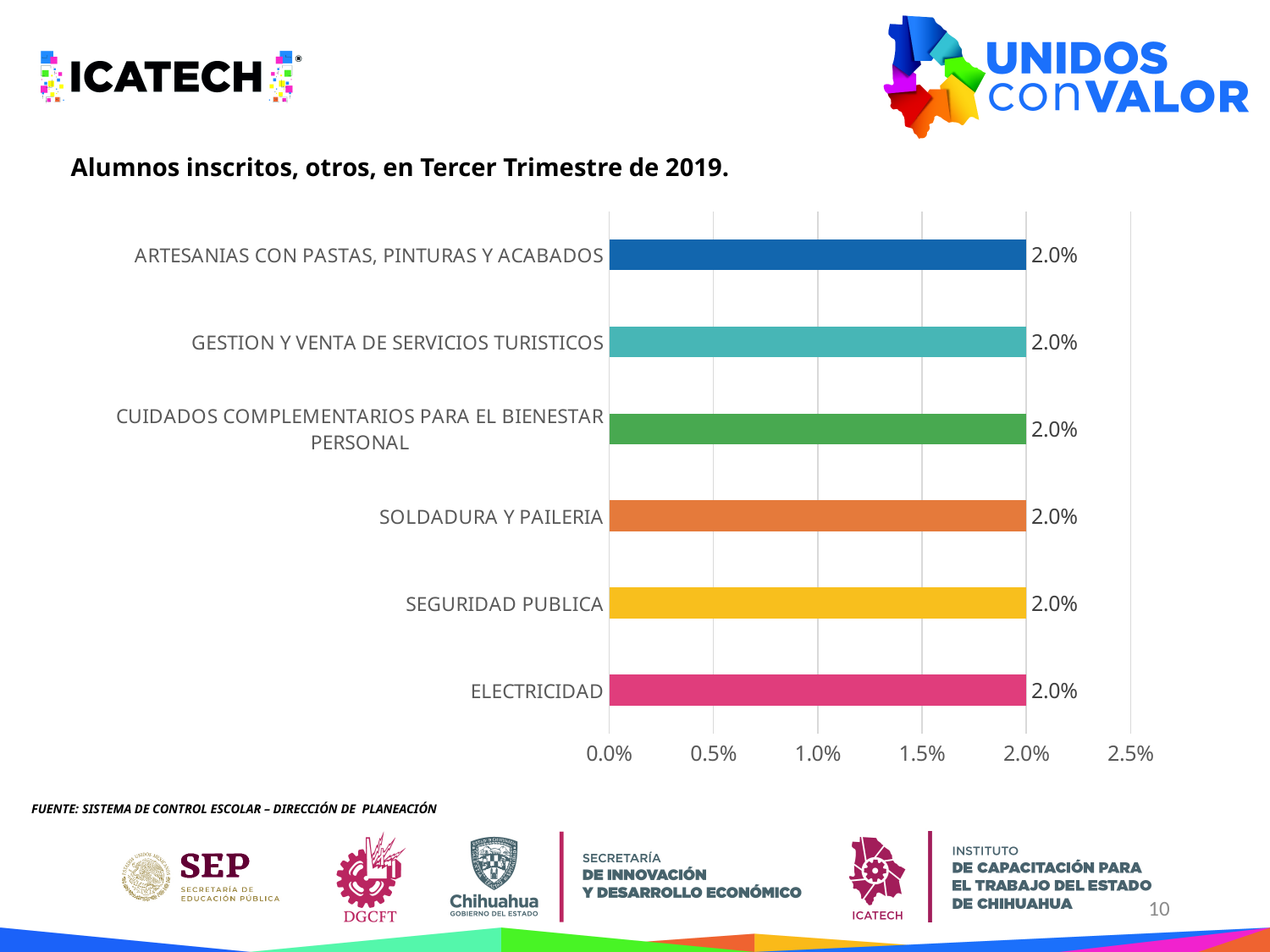
What is the title of the chart? Alumnos inscritos, otros, en Tercer Trimestre de 2019. What is the value for ARTESANIAS CON PASTAS, PINTURAS Y ACABADOS? 2.0% How many categories are shown in the chart? 6 What is the value for ELECTRICIDAD? 2.0% What is the value for GESTION Y VENTA DE SERVICIOS TURISTICOS? 2.0% What is the value for SEGURIDAD PUBLICA? 2.0% Is the value for ELECTRICIDAD greater or less than 2.5%? less What kind of chart is shown on the slide? Bar chart What is the highest value shown on the x axis? 2.5% What is the value for SOLDADURA Y PAILERIA? 2.0% What is the difference between the values for ELECTRICIDAD and SEGURIDAD PUBLICA? 0.0% Is the value for CUIDADOS COMPLEMENTARIOS PARA EL BIENESTAR PERSONAL greater or less than 1.5%? greater